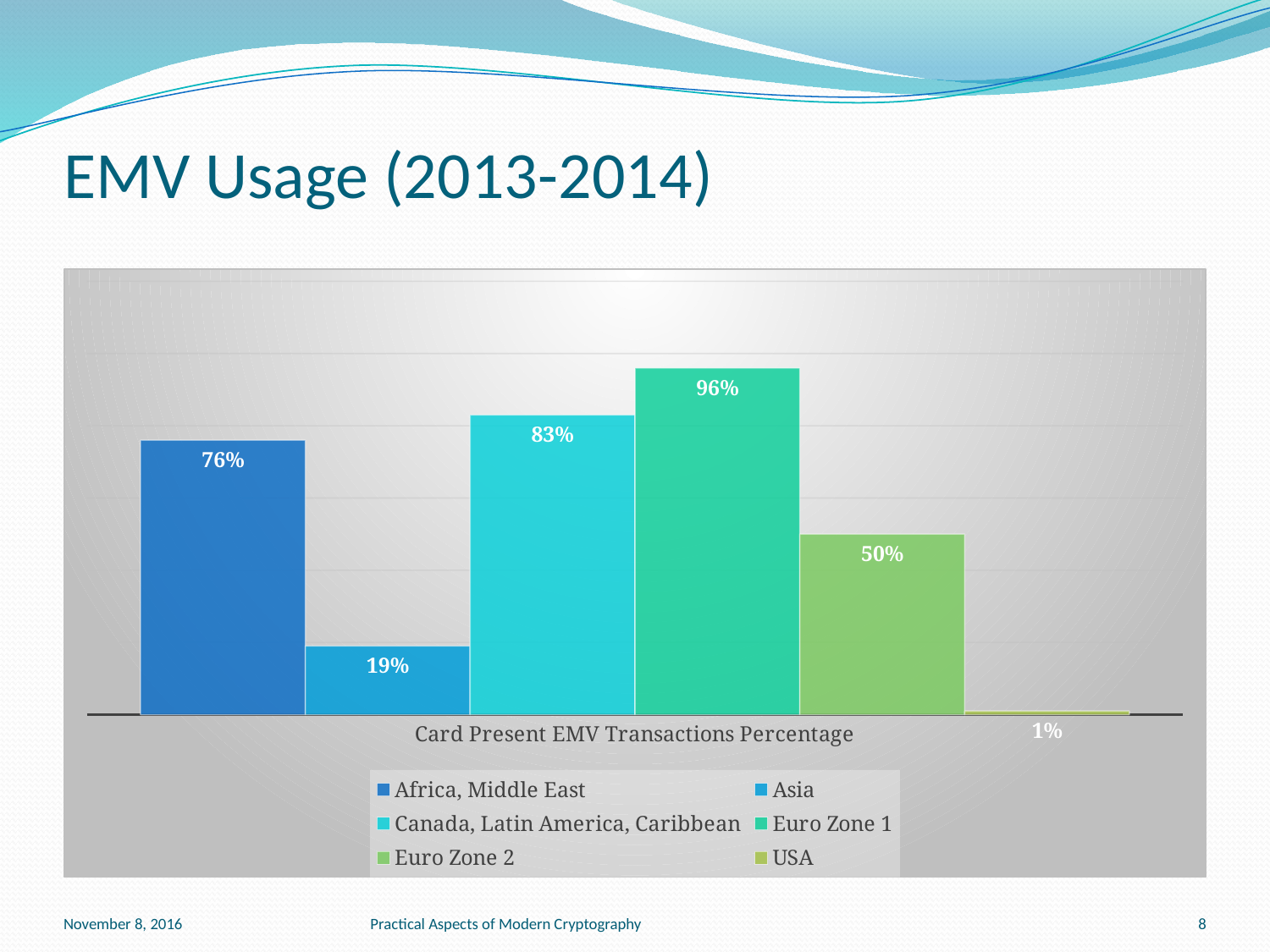
What is the difference between the Canada, Latin America, Caribbean percentage and the Asia percentage? 64% What is the Card Present EMV Transactions Percentage for the USA? 1% What kind of chart is shown on the slide? Bar chart Which is larger, the percentage for Africa, Middle East or for Canada, Latin America, Caribbean? Canada, Latin America, Caribbean Which region has the highest Card Present EMV Transactions Percentage? Euro Zone 1 How many series does the legend list? 6 What is the Card Present EMV Transactions Percentage for Euro Zone 1? 96% What is the Card Present EMV Transactions Percentage for Africa, Middle East? 76% What is the Card Present EMV Transactions Percentage for Asia? 19% What is the difference between the Euro Zone 1 and Euro Zone 2 percentages? 46% What is the label on the x axis of the chart? Card Present EMV Transactions Percentage Which region has the lowest Card Present EMV Transactions Percentage? USA